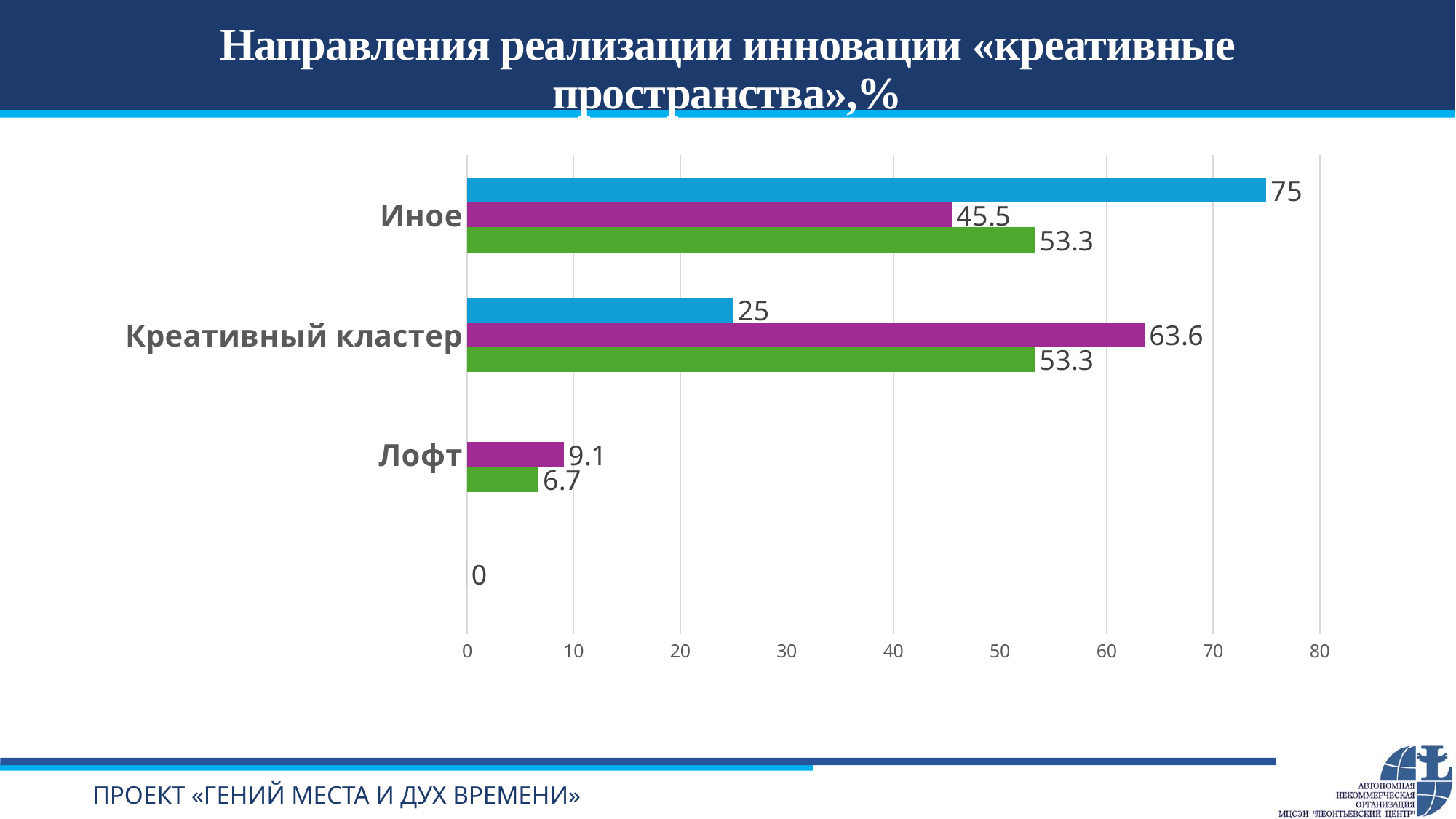
What is the value of the green bar for Лофт? 6.7 How many differently coloured bar series are plotted in the chart? 3 What is the value of the purple bar for Иное? 45.5 What is the value of the purple bar for Креативный кластер? 63.6 What is the title of the chart on the slide? Направления реализации инновации «креативные пространства»,% Which is larger for Креативный кластер: the purple bar or the green bar? the purple bar Which category has the lowest purple bar? Лофт How many labelled categories are shown on the vertical axis? 3 What is the difference between the blue bar for Иное and the blue bar for Креативный кластер? 50 What is the value of the blue bar for Иное? 75 What kind of chart is shown on the slide? bar chart Which category has the highest blue bar? Иное